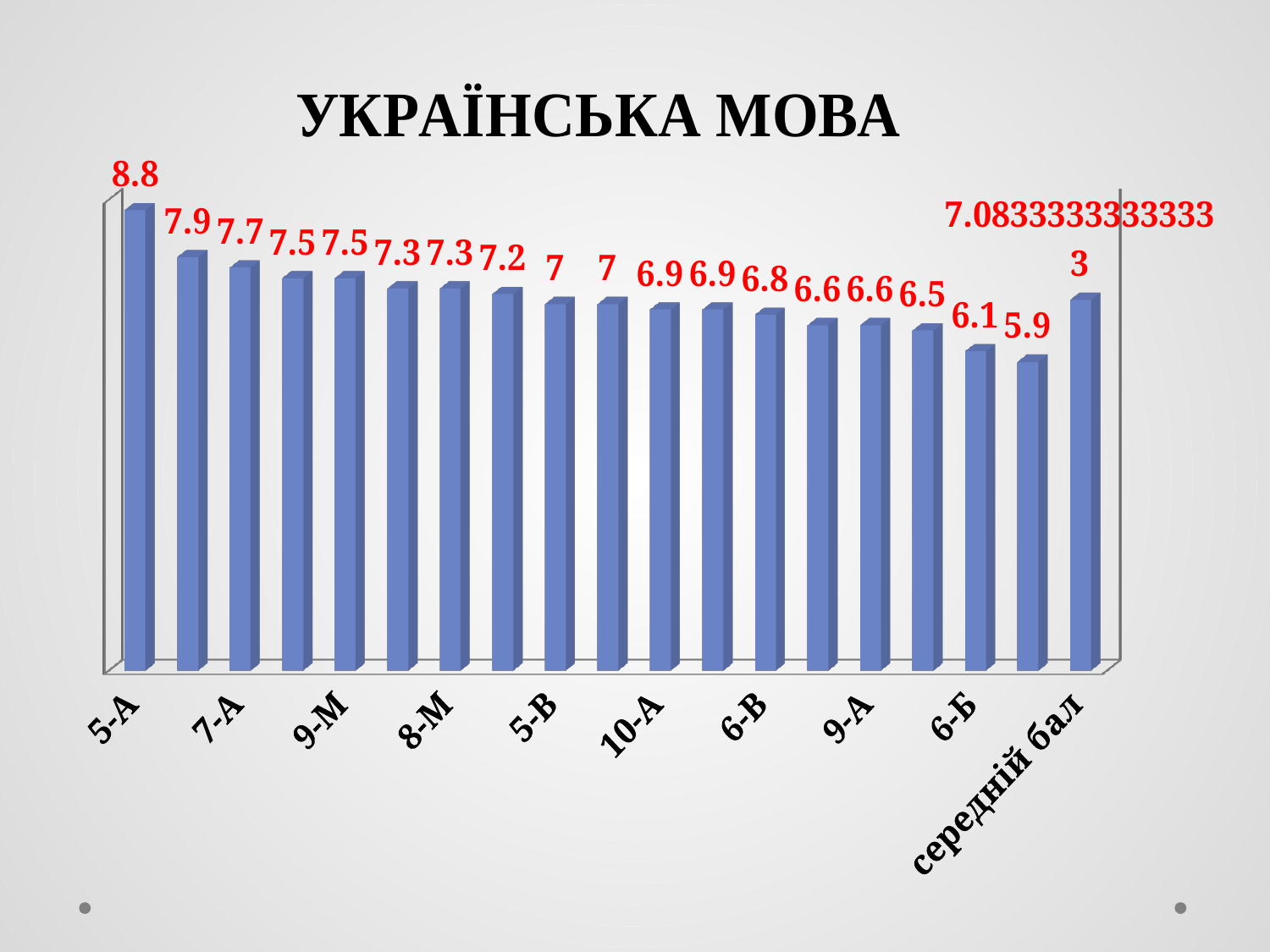
What is the value for 9-М? 7.5 What is the value for 6-Б? 6.1 What is the value for 5-А? 8.8 How many bars are plotted on the chart? 19 Which is larger, the value for 8-М or the value for 9-А? 8-М What is the value for 7-А? 7.7 What is the lowest value shown on the chart? 5.9 What is the value for 10-А? 6.9 What kind of chart is shown? bar chart What is the title of the chart? УКРАЇНСЬКА МОВА What is the difference between the values for 5-А and 6-Б? 2.7 Which class has the highest value? 5-А